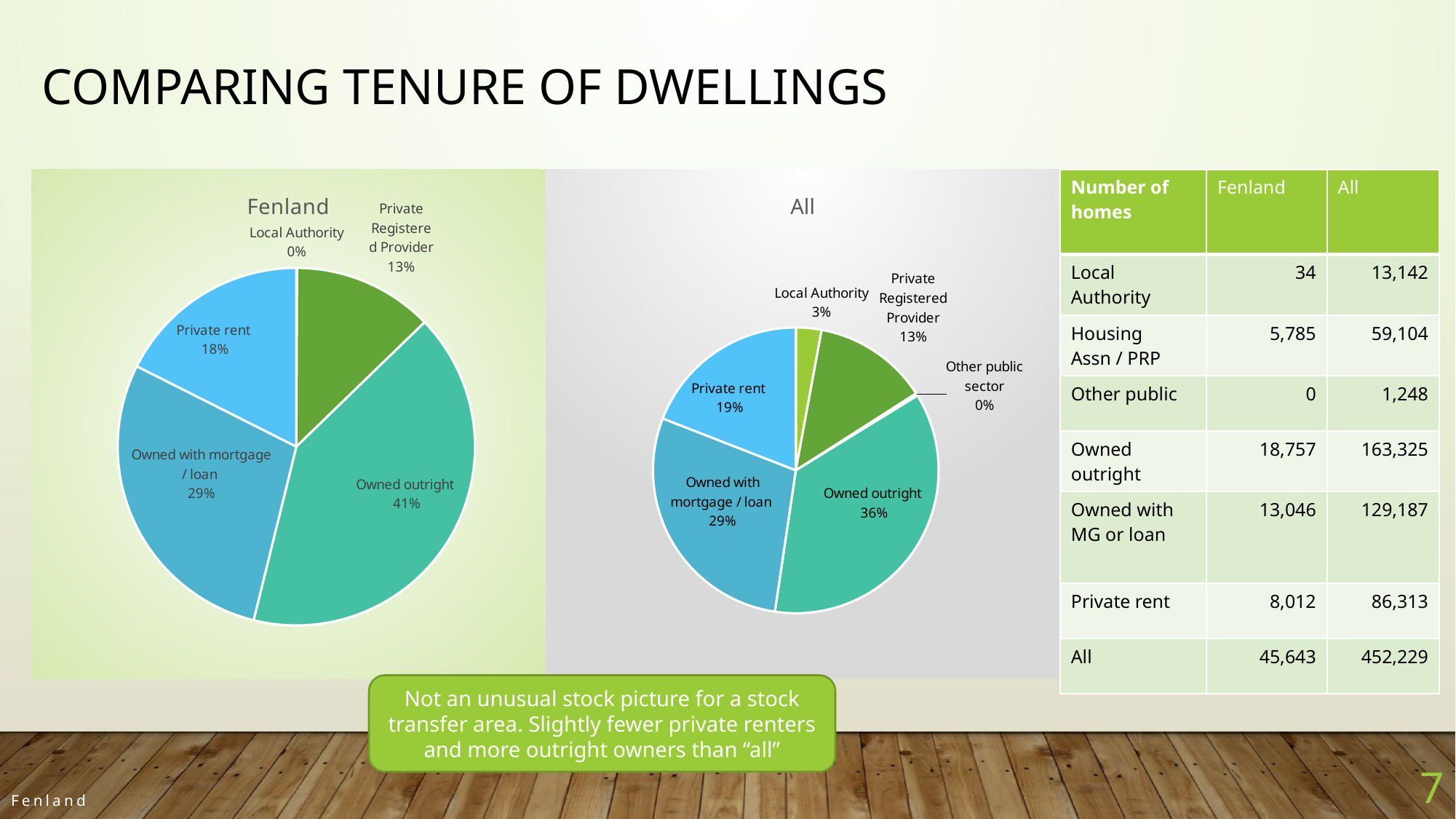
Which is larger: the Private rent share in the Fenland pie chart or in the All pie chart? All What is the title of the pie chart on the left? Fenland In the Fenland pie chart, what is the difference between the Owned outright share and the Owned with mortgage / loan share? 12% In the All pie chart, which category has the largest share? Owned outright In the All pie chart, what share is Local Authority? 3% How many categories are labelled in the Fenland pie chart? 5 In the Fenland pie chart, what share is Owned outright? 41% In the Fenland pie chart, what share is Private rent? 18% In the All pie chart, what share is Owned outright? 36% In the Fenland pie chart, which category has the largest share? Owned outright What type of chart is used for the Fenland data? Pie chart How many categories are labelled in the All pie chart? 6